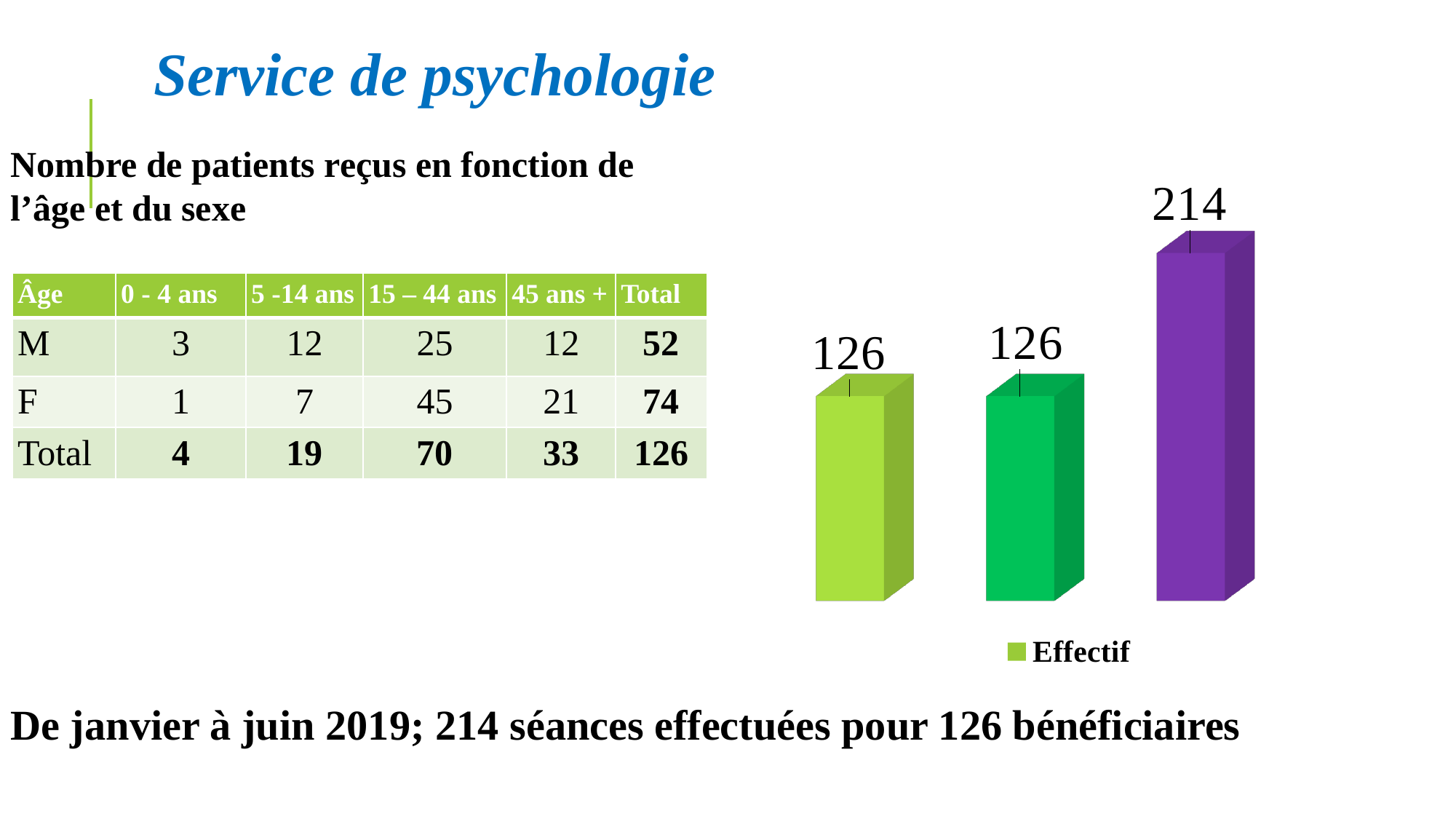
Which is larger: the value of the rightmost bar or the value of the leftmost bar? the rightmost bar How many bars does the chart show? 3 What is the value shown on the leftmost (light green) bar in the chart? 126 What colour is the tallest bar in the chart? purple How many series does the chart legend list? 1 What is the difference between the value of the purple bar and the value of the green middle bar? 88 What is the value shown on the purple bar (rightmost) in the chart? 214 What is the name of the series listed in the chart legend? Effectif What is the value shown on the middle (green) bar in the chart? 126 Which bar has the highest value in the chart? the purple (rightmost) bar, 214 Do the values of the bars rise or fall from left to right across the chart? rise What kind of chart is shown on the right of the slide? bar chart